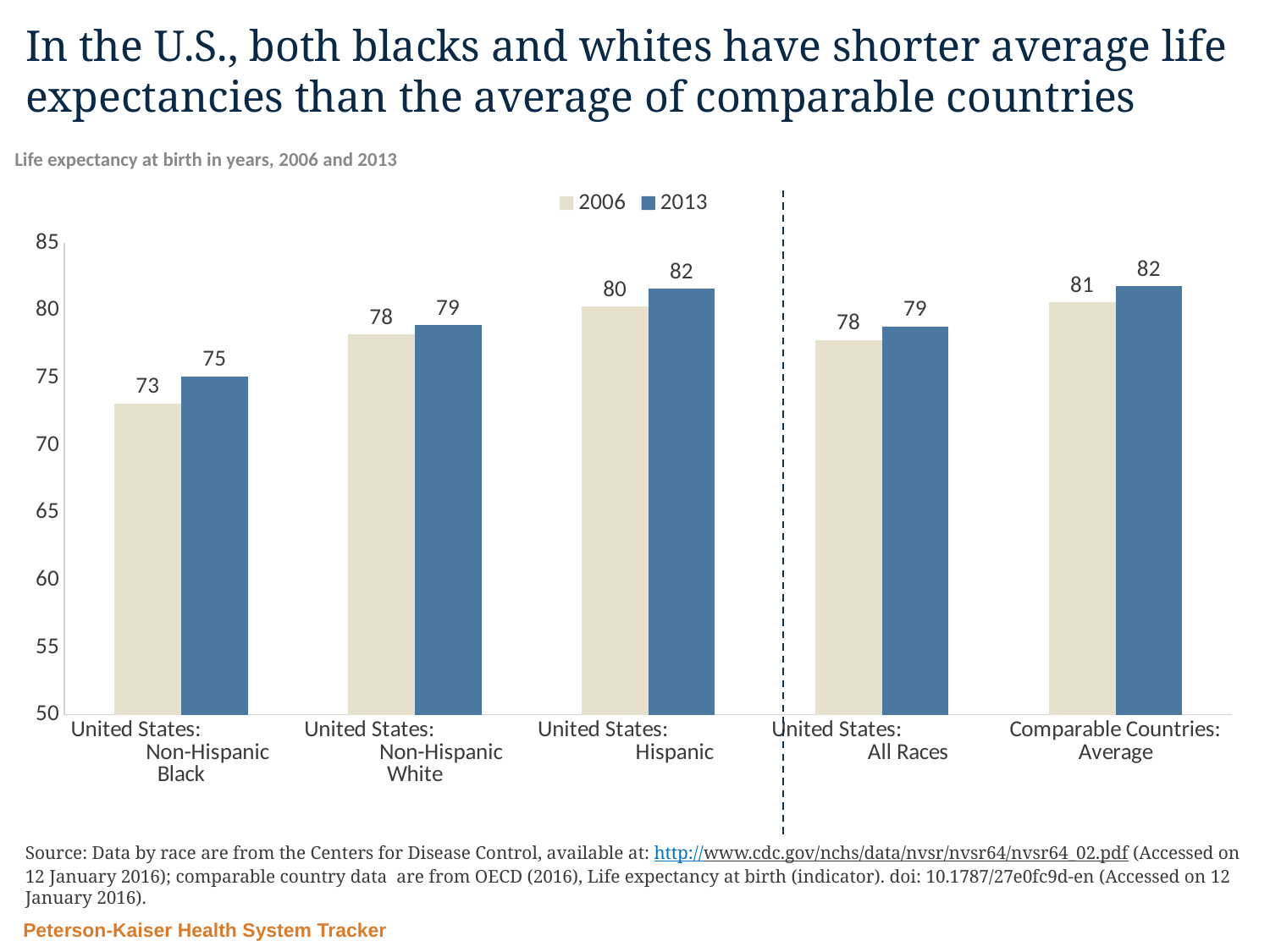
Which category had the highest life expectancy in 2006? Comparable Countries: Average What was the life expectancy at birth for United States: Non-Hispanic Black in 2006? 73 What is the difference between the 2013 and 2006 life expectancy for United States: Non-Hispanic Black? 2 What was the life expectancy at birth for Comparable Countries: Average in 2006? 81 What kind of chart is shown on the slide? Bar chart Which category had the lowest life expectancy in 2006? United States: Non-Hispanic Black How many categories are shown on the x axis? 5 Which years are listed in the legend? 2006 and 2013 How many series does the legend list? 2 What is the difference in 2013 life expectancy between Comparable Countries: Average and United States: All Races? 3 What was the life expectancy at birth for United States: Hispanic in 2013? 82 Which is larger: the 2013 life expectancy for United States: Non-Hispanic White or for United States: Hispanic? United States: Hispanic